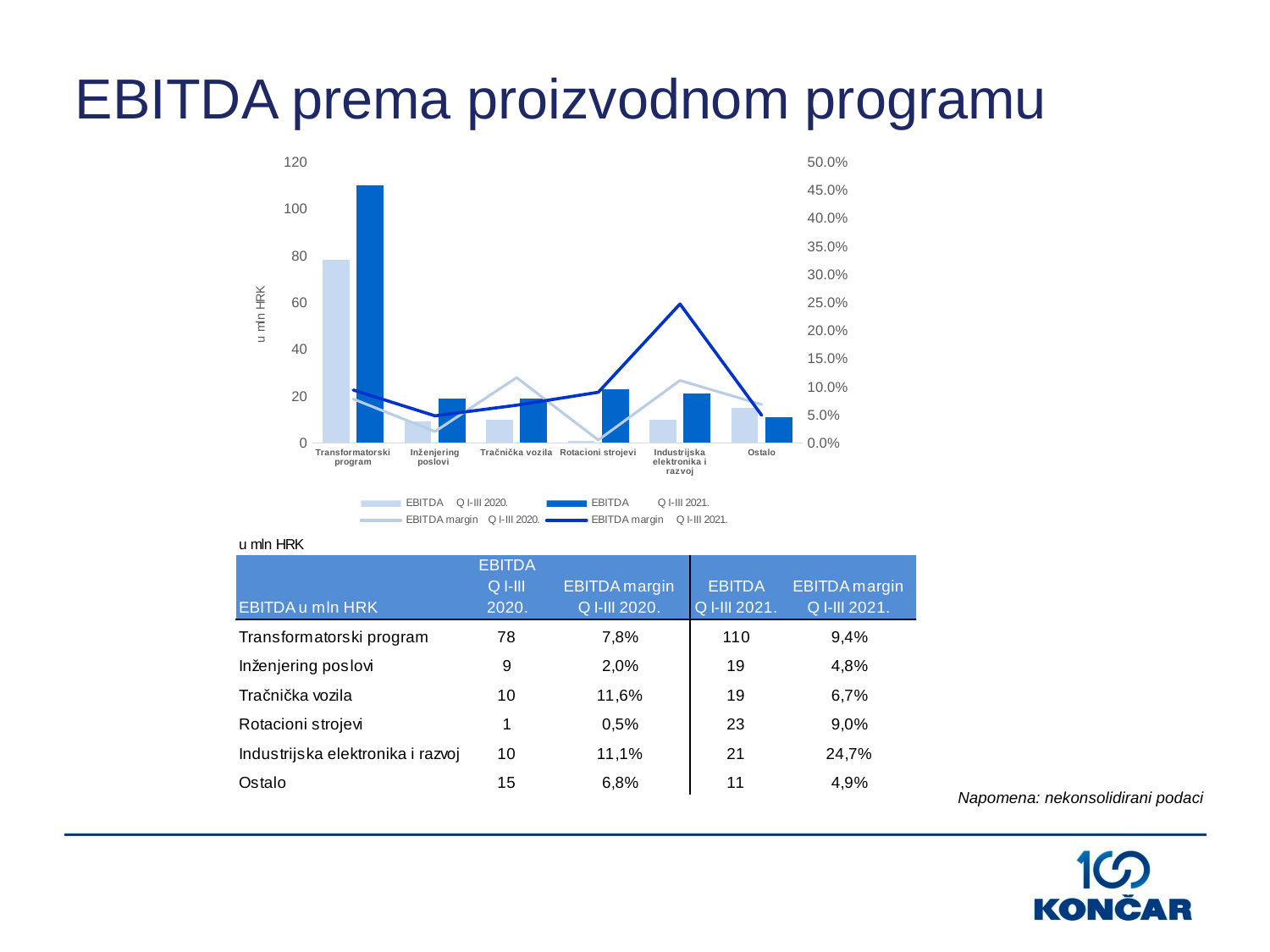
How many series does the chart legend list? 4 Which category has the lowest EBITDA margin in Q I-III 2020? Rotacioni strojevi How many product programme categories are shown on the x axis of the chart? 6 Which category has the highest EBITDA in Q I-III 2021? Transformatorski program What is the difference between the EBITDA of Transformatorski program in Q I-III 2021 and Q I-III 2020? 32 What is the EBITDA for Rotacioni strojevi in Q I-III 2020? 1 Is the EBITDA bar for Transformatorski program in Q I-III 2021 greater or less than 100? greater What kind of chart is shown on the slide? Combined bar and line chart What is the EBITDA for Transformatorski program in Q I-III 2021? 110 What is the EBITDA margin for Industrijska elektronika i razvoj in Q I-III 2021? 24,7% What unit is shown on the left vertical axis of the chart? u mln HRK Which is larger, the EBITDA of Ostalo in Q I-III 2020 or in Q I-III 2021? Q I-III 2020